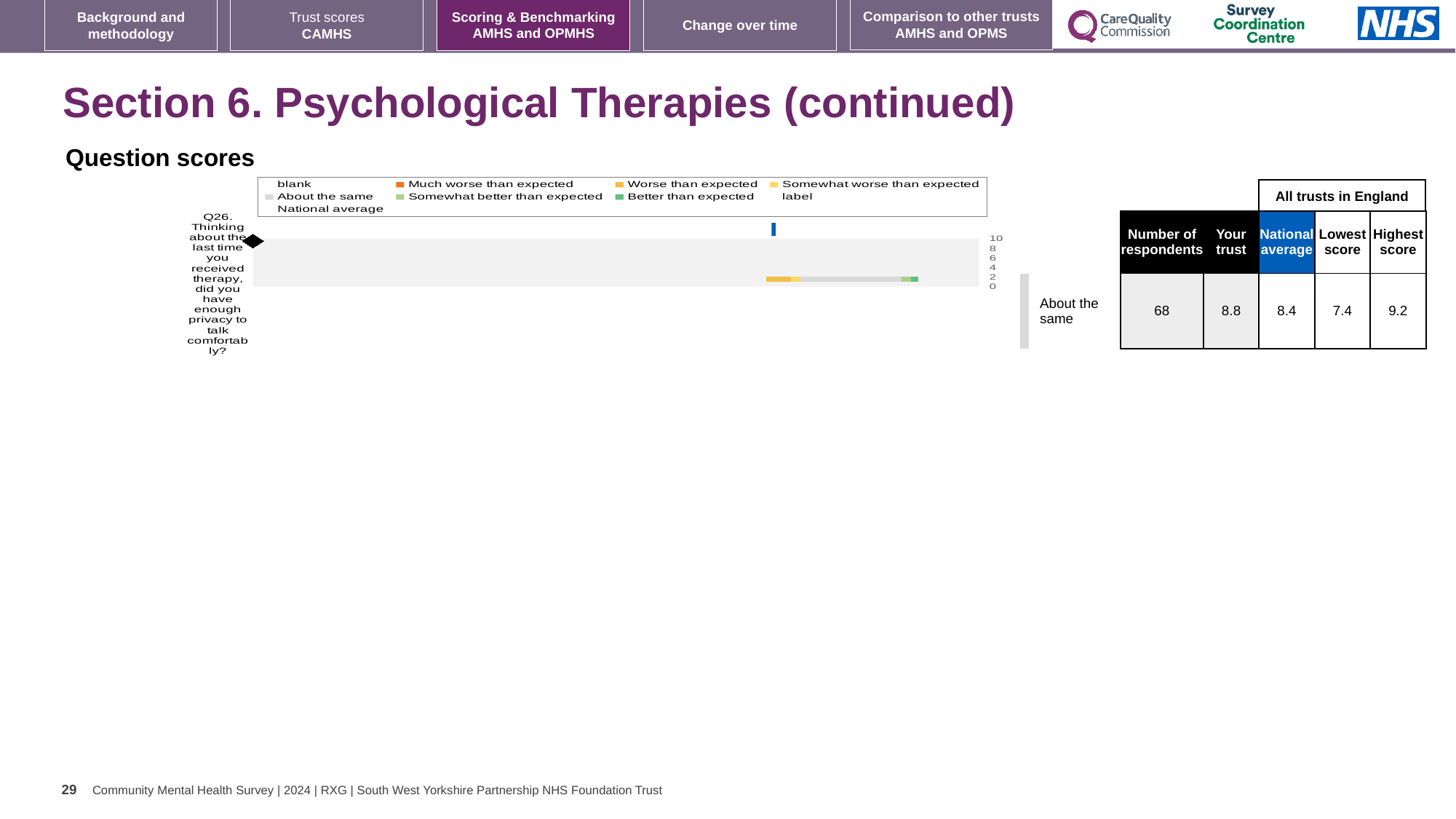
Which question number is plotted in the chart? Q26 How many questions (categories) are plotted in the chart? 1 What benchmark category is written beside the chart for Q26? About the same What is the highest value shown on the chart's numeric axis? 10 In the table next to the chart, what is the number of respondents for Q26? 68 What kind of chart is shown under 'Question scores'? bar chart In the table next to the chart, what is the 'Your trust' score for Q26? 8.8 In the table next to the chart, what is the highest score among all trusts in England for Q26? 9.2 In the table next to the chart, what is the lowest score among all trusts in England for Q26? 7.4 In the table next to the chart, what is the national average score for Q26? 8.4 Which is larger for Q26, the 'Your trust' score or the national average? Your trust What is the difference between the highest score (9.2) and the lowest score (7.4) for Q26? 1.8